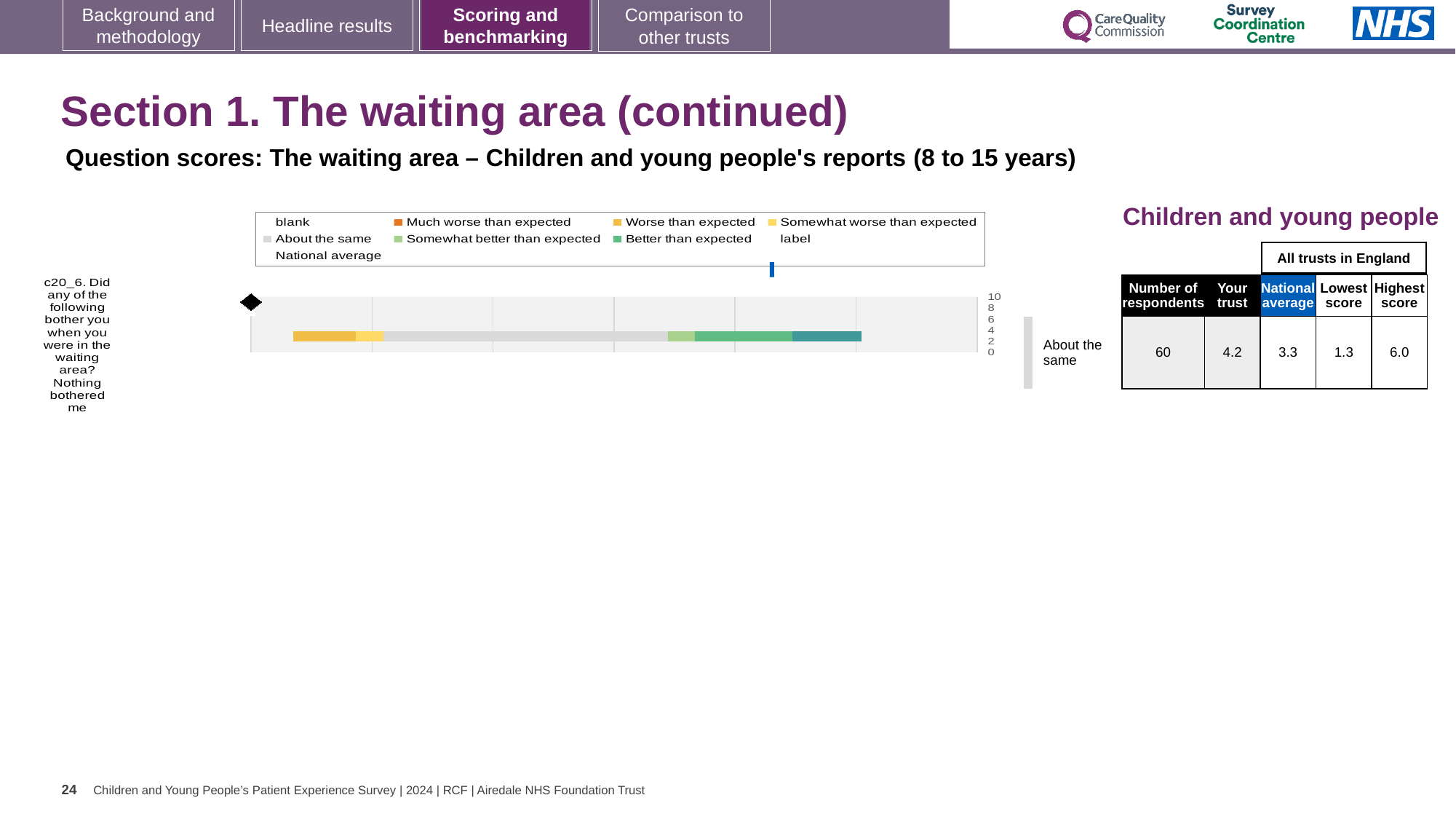
What is the difference between the 'Your trust' score and the national average for question c20_6? 0.9 What benchmark category is shown to the right of the bar for question c20_6? About the same What is the national average score for question c20_6 in the table? 3.3 What is the highest score across all trusts in England for question c20_6? 6.0 How many survey questions are plotted in the chart? 1 What is the 'Your trust' score for question c20_6 in the table? 4.2 What kind of chart is shown on the slide? bar chart How many respondents answered question c20_6? 60 What is the difference between the highest score and the lowest score for question c20_6? 4.7 Which survey question is plotted in the chart? c20_6. Did any of the following bother you when you were in the waiting area? Nothing bothered me What is the lowest score across all trusts in England for question c20_6? 1.3 Which is larger for question c20_6: the 'Your trust' score or the national average? Your trust